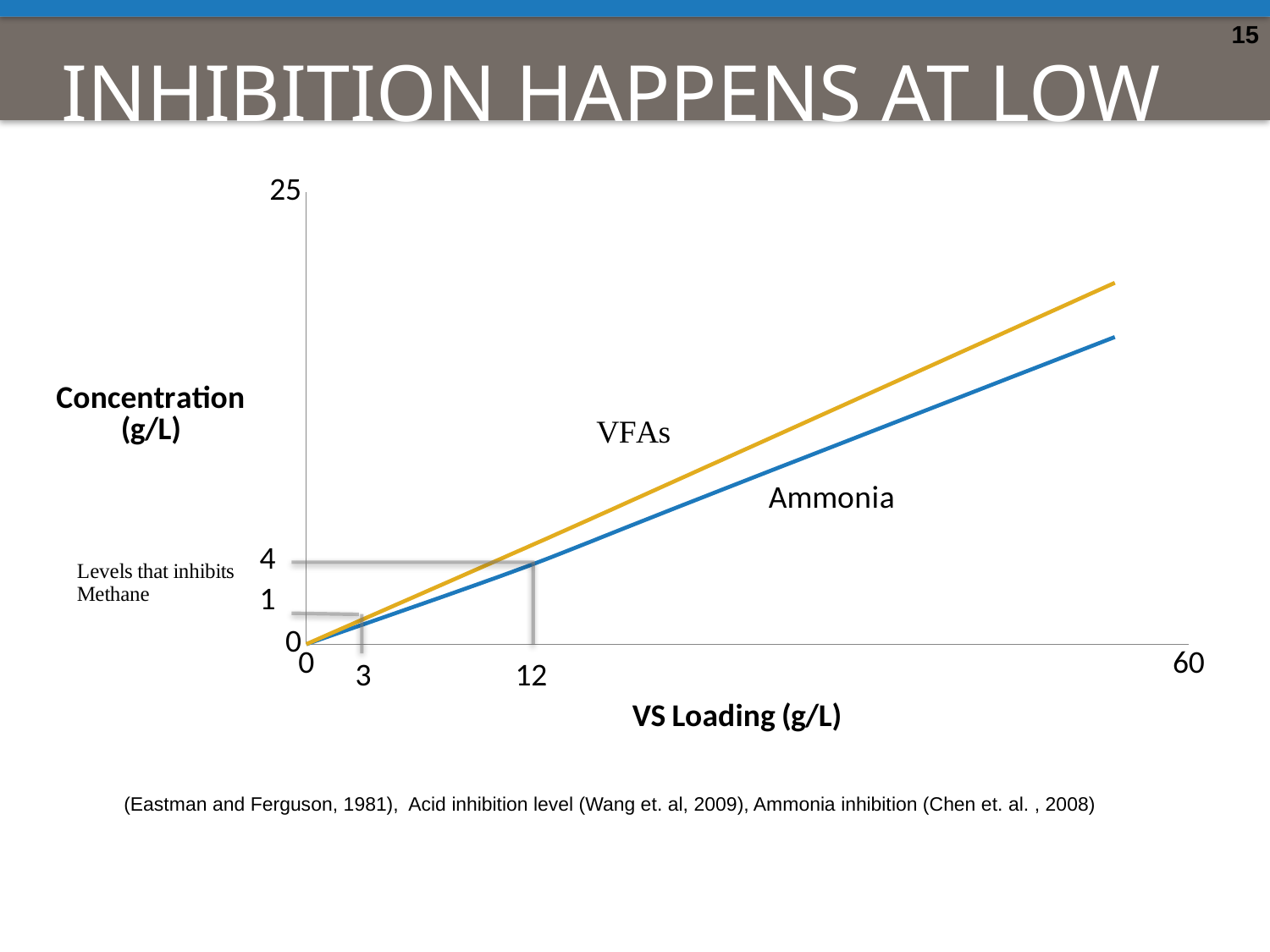
What is the title of the x axis? VS Loading (g/L) According to the guide lines, what concentration does the Ammonia line reach at a VS Loading of 12? 4 What is the highest value shown on the y axis? 25 What are the two series labelled on the chart? VFAs and Ammonia According to the guide lines, what concentration does the Ammonia line reach at a VS Loading of 3? 1 Is the VFAs concentration at the right end of the chart greater or less than 25? less How many lines are plotted on the chart? 2 Do the VFAs and Ammonia lines rise or fall as VS Loading increases? rise At the right end of the chart, which line is higher, VFAs or Ammonia? VFAs Is the Ammonia concentration at the right end of the chart greater or less than 4? greater What kind of chart is shown on the slide? line chart